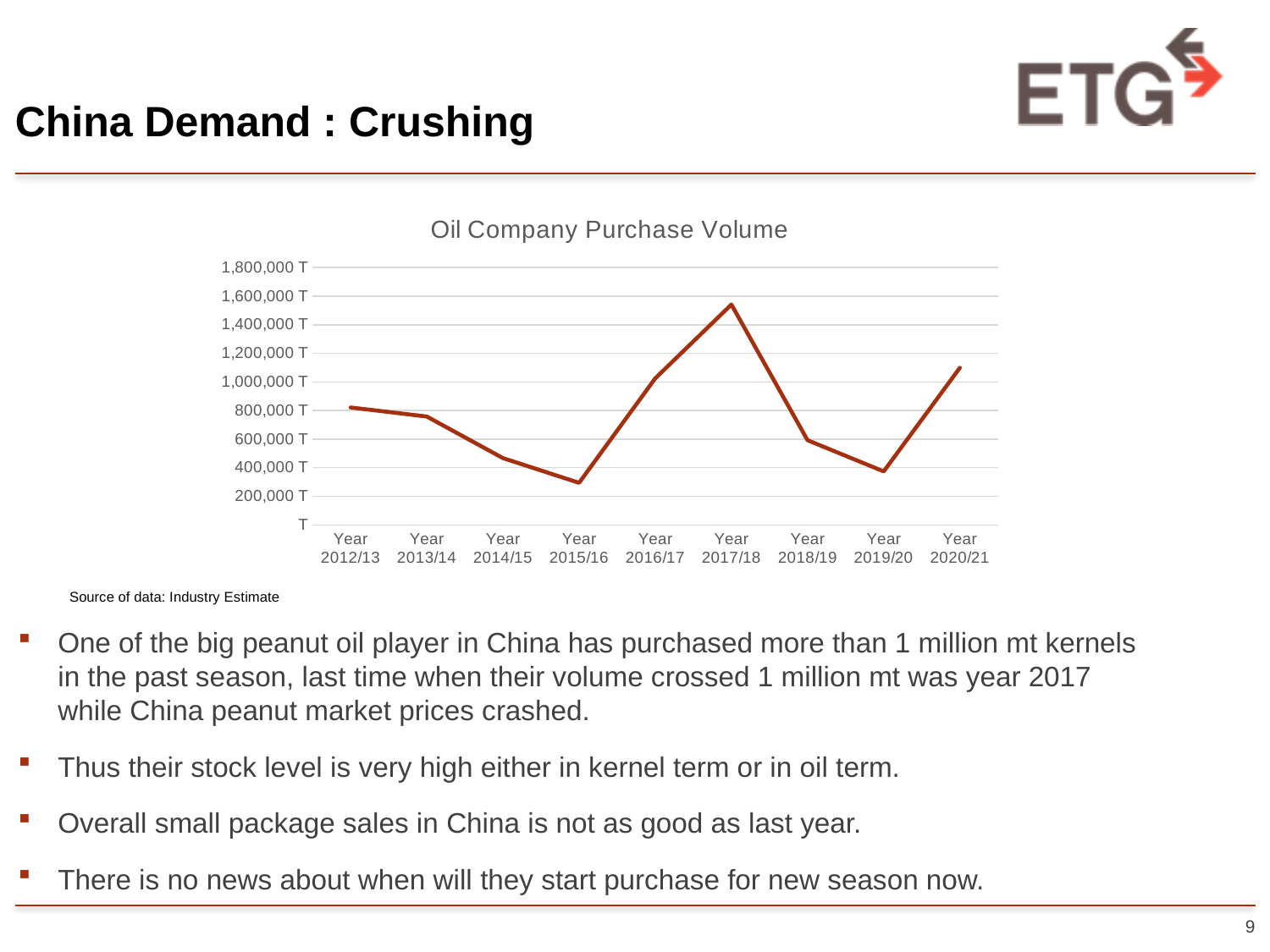
What kind of chart is shown on the slide? line chart How many years are plotted on the x axis of the chart? 9 Does the purchase volume rise or fall from Year 2012/13 to Year 2015/16? fall Is the value for Year 2020/21 greater or less than 1,000,000 T? greater What is the title of the chart? Oil Company Purchase Volume Is the value for Year 2017/18 greater or less than 1,400,000 T? greater Is the value for Year 2019/20 greater or less than 600,000 T? less Which year has the highest purchase volume? Year 2017/18 Which year has the lowest purchase volume? Year 2015/16 Which is larger, the value for Year 2012/13 or the value for Year 2014/15? Year 2012/13 Which is larger, the value for Year 2018/19 or the value for Year 2020/21? Year 2020/21